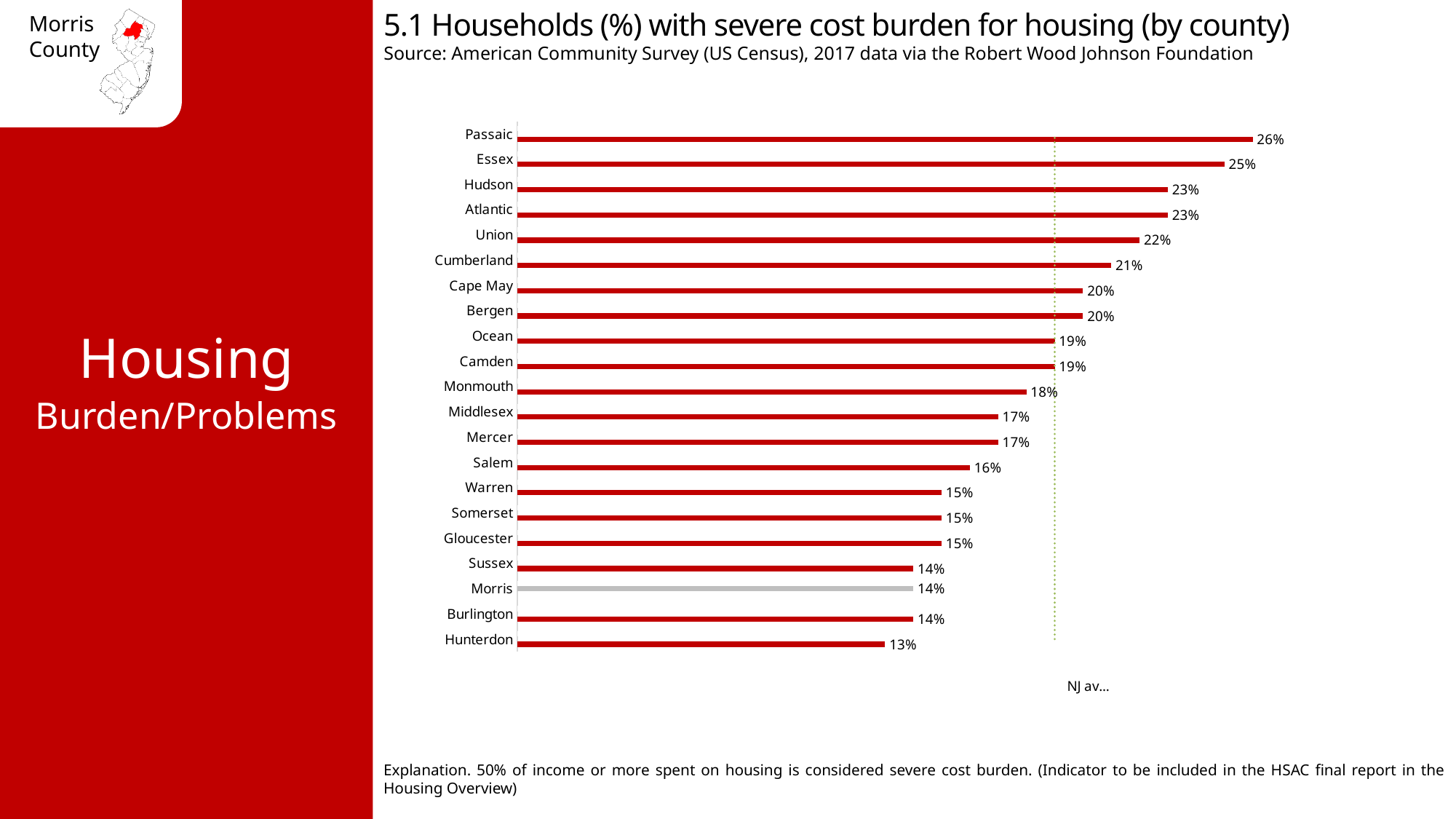
Which county has the highest percentage of households with severe cost burden? Passaic What is the difference between the values for Essex and Morris? 11% What is the value shown for Passaic? 26% What is the value shown for Cumberland? 21% Which has a higher value, Union or Salem? Union How many counties are shown in the chart? 21 What is the difference between the values for Passaic and Hunterdon? 13% What percentage of households in Morris County have a severe housing cost burden? 14% What type of chart is used on this slide? Bar chart Which county has the lowest percentage of households with severe cost burden? Hunterdon Which county's bar is shown in grey rather than red? Morris Which has a higher value, Bergen or Mercer? Bergen